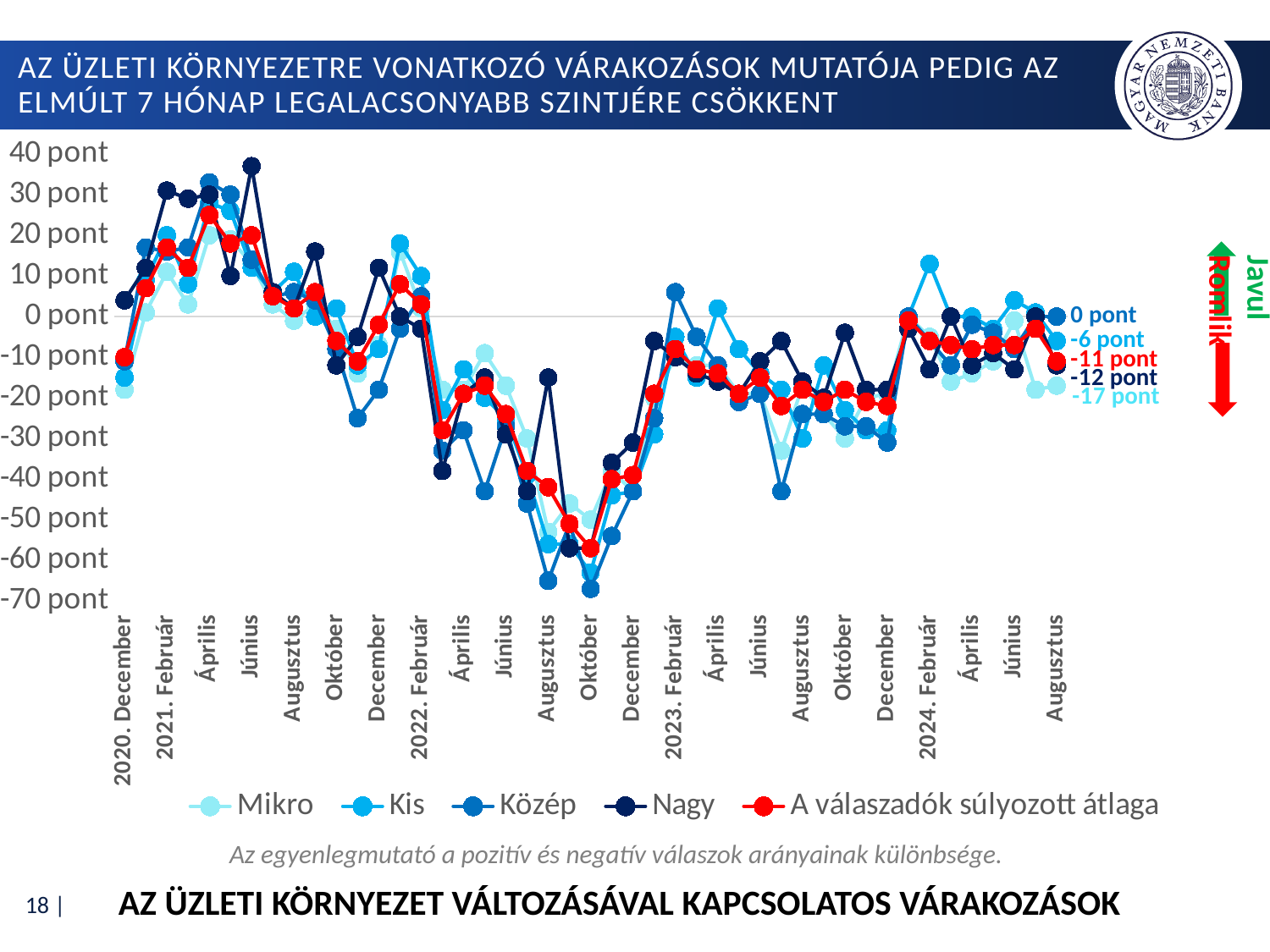
At the last point (2024 Augusztus), what is the difference between the Közép value and the Mikro value? 17 pont What is the value of the Közép series at the last point (2024 Augusztus)? 0 pont Is the value of 'A válaszadók súlyozott átlaga' in 2022 Október greater or less than -50 pont? less Which series has the highest value at the last point (2024 Augusztus)? Közép At the last point (2024 Augusztus), which is higher: Kis or Nagy? Kis What is the value of the Nagy series at the last point (2024 Augusztus)? -12 pont What is the value of 'A válaszadók súlyozott átlaga' at the last point (2024 Augusztus)? -11 pont What is the value of the Mikro series at the last point (2024 Augusztus)? -17 pont What is the value of the Kis series at the last point (2024 Augusztus)? -6 pont What kind of chart is shown on the slide? line chart Which series has the lowest value at the last point (2024 Augusztus)? Mikro How many series does the legend list? 5